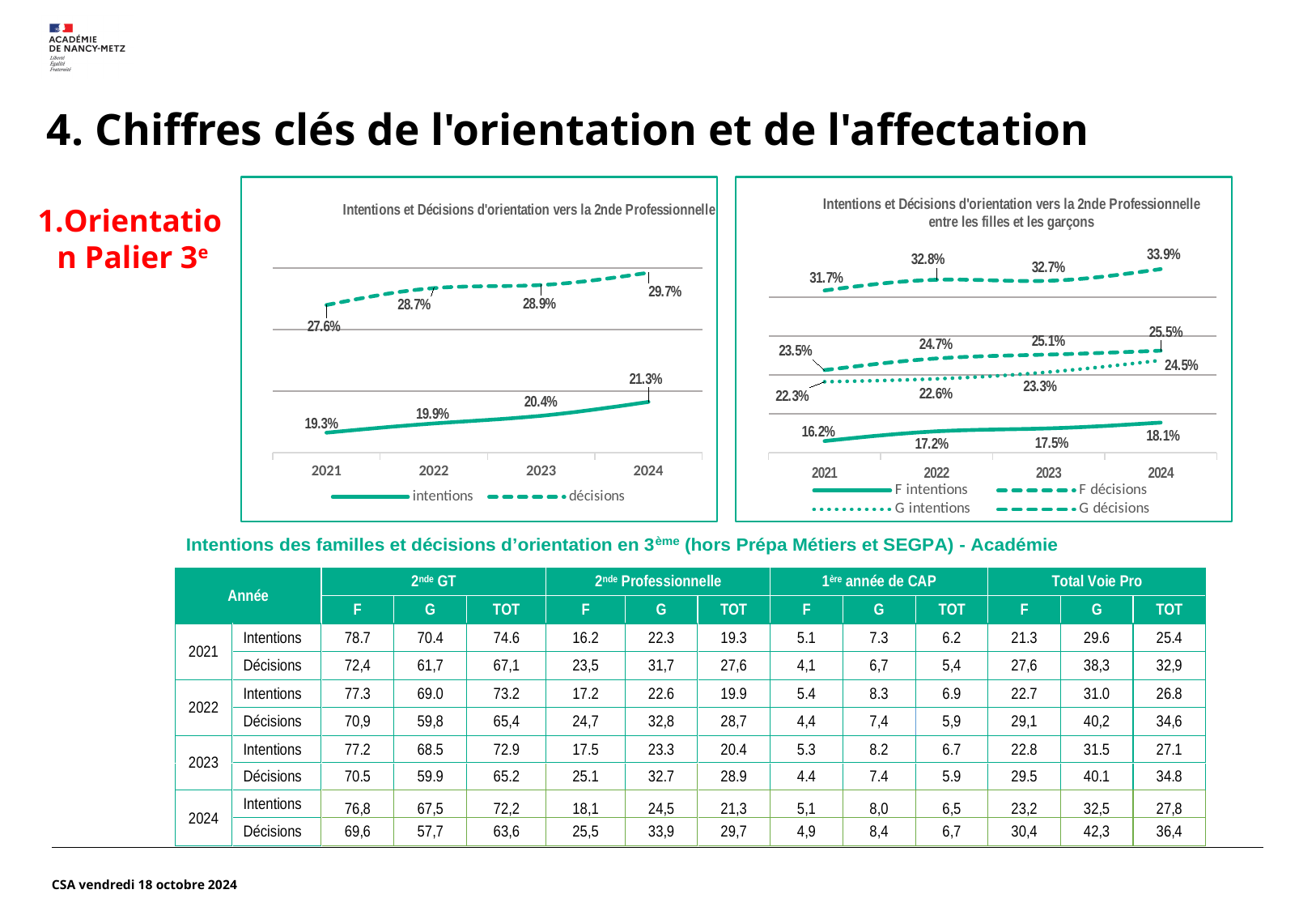
In the left chart 'Intentions et Décisions d'orientation vers la 2nde Professionnelle', what is the value of the intentions series in 2024? 21.3% In the left chart 'Intentions et Décisions d'orientation vers la 2nde Professionnelle', what is the value of the décisions series in 2021? 27.6% In the left chart 'Intentions et Décisions d'orientation vers la 2nde Professionnelle', does the intentions series rise or fall from 2021 to 2024? rise In the right chart 'entre les filles et les garçons', what is the value of F intentions in 2022? 17.2% In the left chart 'Intentions et Décisions d'orientation vers la 2nde Professionnelle', how many series does the legend list? 2 What kind of chart is the left chart 'Intentions et Décisions d'orientation vers la 2nde Professionnelle'? line chart In the right chart 'entre les filles et les garçons', which is larger in 2024: F décisions or G intentions? F décisions In the right chart 'entre les filles et les garçons', how many years are shown on the x axis? 4 In the left chart 'Intentions et Décisions d'orientation vers la 2nde Professionnelle', what is the difference between décisions and intentions in 2023? 8.5 percentage points In the right chart 'entre les filles et les garçons', what is the value of G décisions in 2024? 33.9% In the right chart 'entre les filles et les garçons', how many series does the legend list? 4 In the right chart 'entre les filles et les garçons', which series has the lowest value in 2021? F intentions